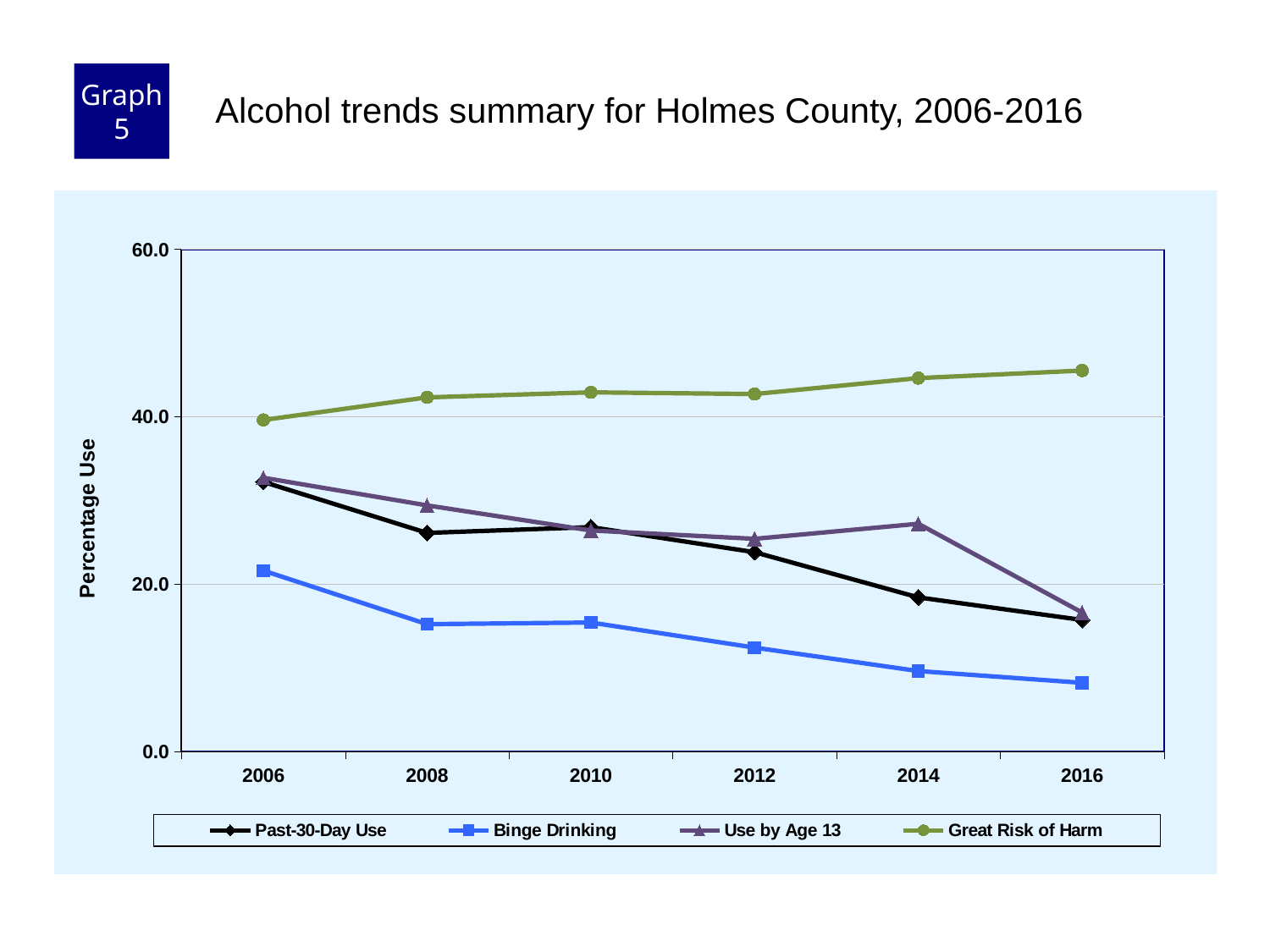
Does the Binge Drinking line rise or fall from 2006 to 2016? Fall What is the label on the y axis? Percentage Use Is the value for Great Risk of Harm in 2016 greater or less than 40.0? greater In 2014, which is larger: Use by Age 13 or Past-30-Day Use? Use by Age 13 Which series has the lowest value in 2016? Binge Drinking How many years are plotted along the x axis? 6 How many series does the legend list? 4 Which series has the highest value in 2016? Great Risk of Harm Is the value for Binge Drinking in 2016 greater or less than 20.0? less What kind of chart is shown on the slide? Line chart Does the Great Risk of Harm line rise or fall from 2006 to 2016? Rise Is the value for Past-30-Day Use in 2006 greater or less than 20.0? greater